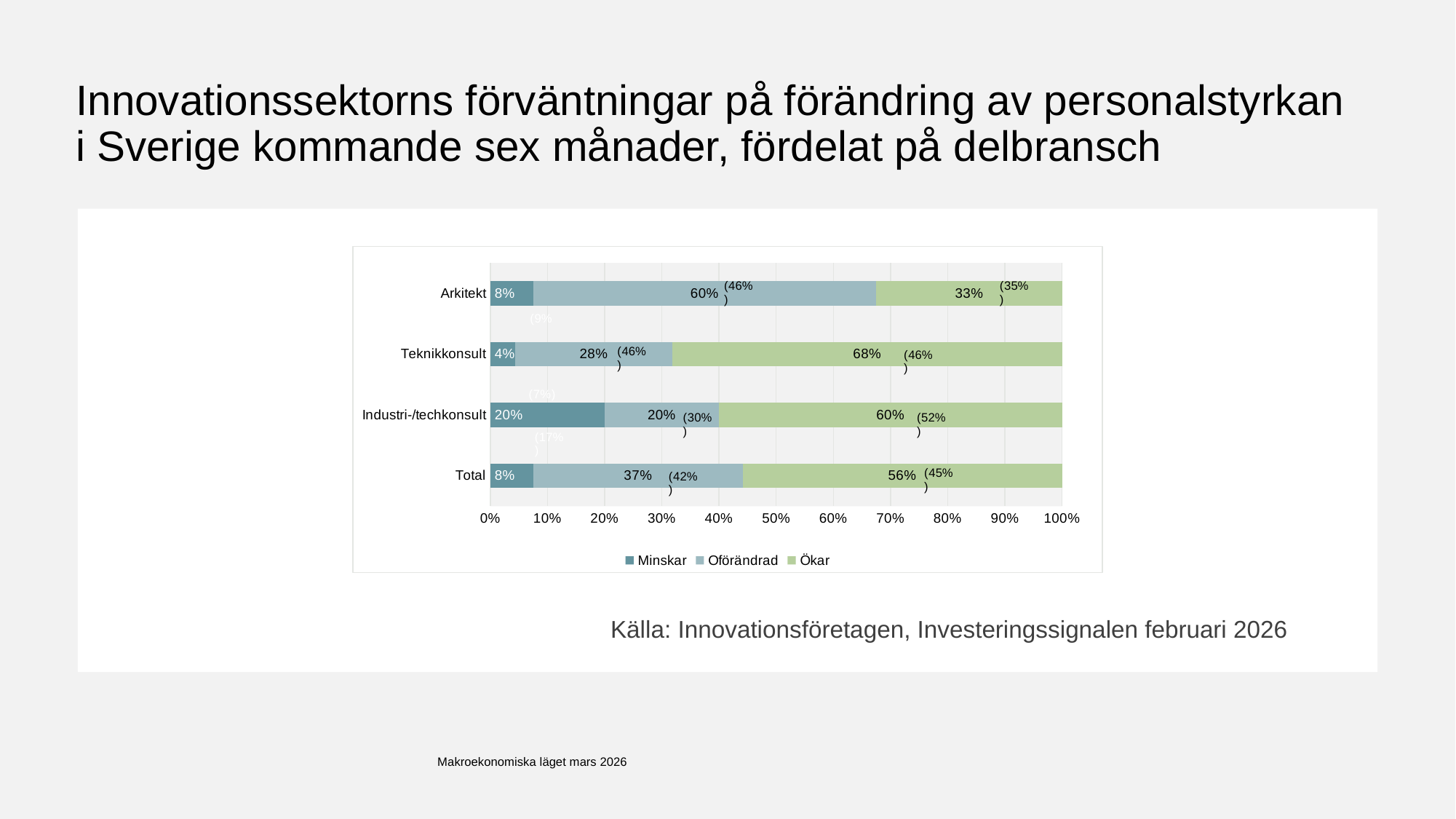
What is the Minskar value for Industri-/techkonsult? 20% What is the Ökar value for Total? 56% Which category has the lowest Ökar value? Arkitekt What kind of chart is shown on the slide? Stacked bar chart What is the Ökar value for Teknikkonsult? 68% Which category has the highest Minskar value? Industri-/techkonsult What is the Oförändrad value for Arkitekt? 60% Which is larger, the Oförändrad value for Total or the Oförändrad value for Teknikkonsult? Total How many categories are shown on the chart? 4 What are the three legend entries of the chart? Minskar, Oförändrad, Ökar How many series does the legend list? 3 What is the difference between the Ökar values for Teknikkonsult and Arkitekt? 35 percentage points